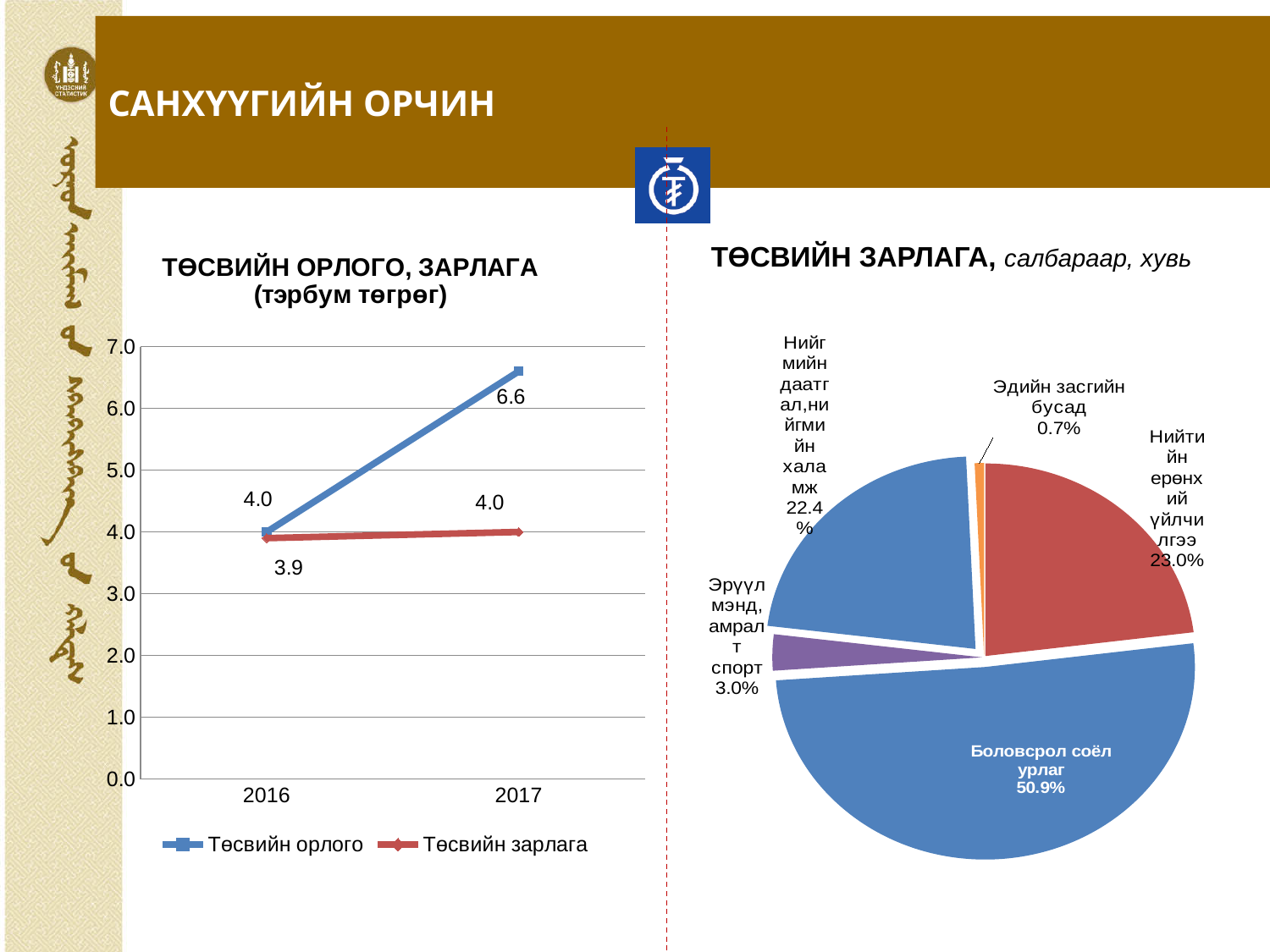
In the pie chart 'ТӨСВИЙН ЗАРЛАГА, салбараар, хувь', what is the share of Эрүүл мэнд, амралт спорт? 3.0% How many slices does the pie chart 'ТӨСВИЙН ЗАРЛАГА, салбараар, хувь' have? 5 In the chart 'ТӨСВИЙН ОРЛОГО, ЗАРЛАГА (тэрбум төгрөг)', which series has the higher value in 2017, Төсвийн орлого or Төсвийн зарлага? Төсвийн орлого In the chart 'ТӨСВИЙН ОРЛОГО, ЗАРЛАГА (тэрбум төгрөг)', does Төсвийн орлого rise or fall from 2016 to 2017? rise In the pie chart 'ТӨСВИЙН ЗАРЛАГА, салбараар, хувь', what is the difference between the shares of Нийтийн ерөнхий үйлчилгээ and Нийгмийн даатгал, нийгмийн халамж? 0.6% What kind of chart is 'ТӨСВИЙН ОРЛОГО, ЗАРЛАГА (тэрбум төгрөг)'? line chart In the pie chart 'ТӨСВИЙН ЗАРЛАГА, салбараар, хувь', which sector has the smallest share? Эдийн засгийн бусад In the pie chart 'ТӨСВИЙН ЗАРЛАГА, салбараар, хувь', what share does Боловсрол соёл урлаг have? 50.9% How many series does the legend of the chart 'ТӨСВИЙН ОРЛОГО, ЗАРЛАГА (тэрбум төгрөг)' list? 2 In the chart 'ТӨСВИЙН ОРЛОГО, ЗАРЛАГА (тэрбум төгрөг)', what is the value of Төсвийн зарлага in 2016? 3.9 In the chart 'ТӨСВИЙН ОРЛОГО, ЗАРЛАГА (тэрбум төгрөг)', what is the value of Төсвийн орлого in 2017? 6.6 In the chart 'ТӨСВИЙН ОРЛОГО, ЗАРЛАГА (тэрбум төгрөг)', by how much did Төсвийн орлого increase from 2016 to 2017? 2.6